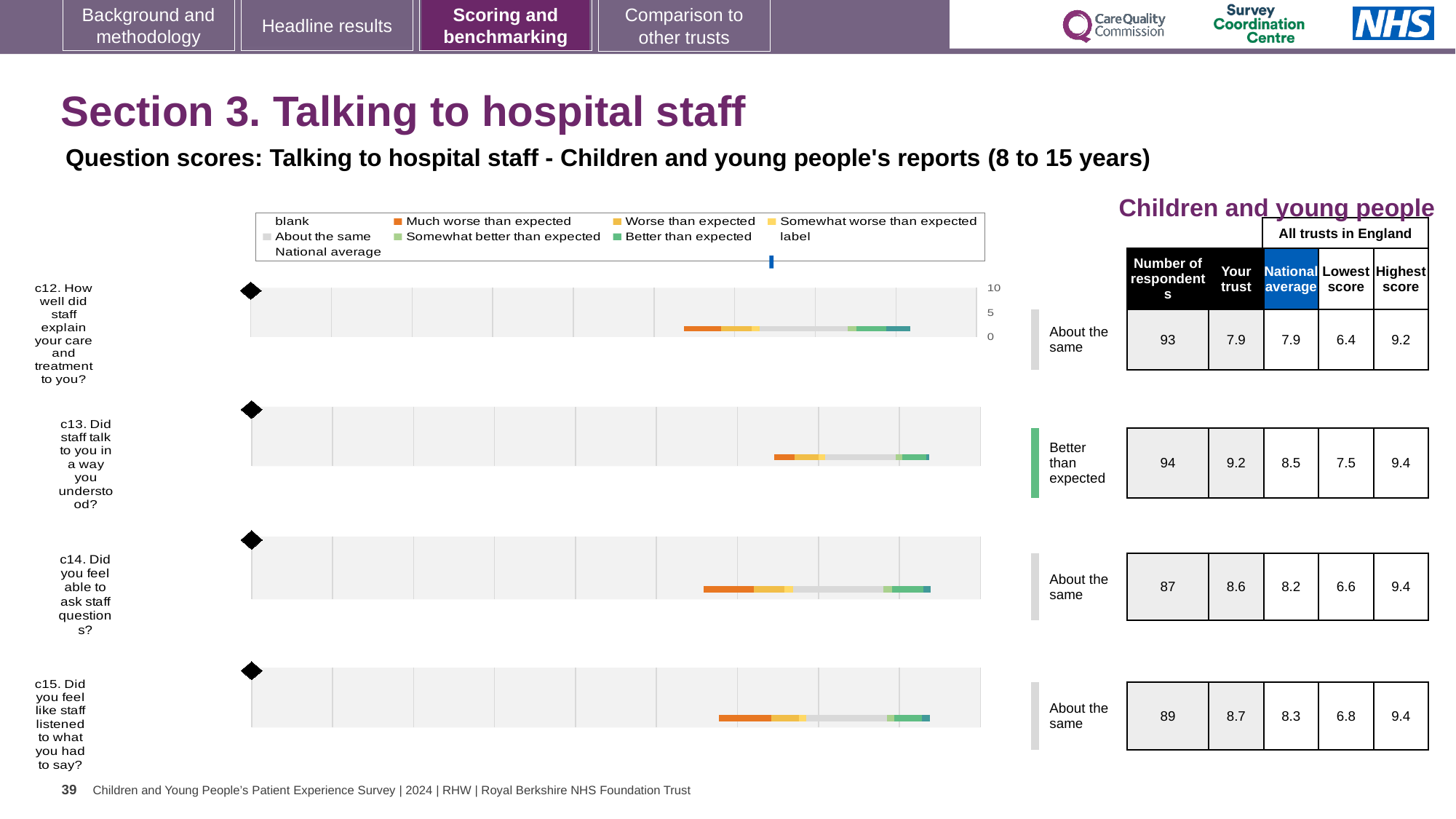
What is the highest tick value shown on the axis of the c12 chart? 10 Which question has the lowest 'Your trust' score? c12 For c14, which is larger: the 'Your trust' score or the national average? Your trust What is the difference between the 'Your trust' score and the national average for c13? 0.7 What kind of chart is used for each question on the slide? bar chart How many question charts are shown on the slide? 4 Which question has the highest 'Your trust' score? c13 How many respondents are listed for c14 (Did you feel able to ask staff questions?)? 87 What is the 'Your trust' score for c13 (Did staff talk to you in a way you understood?)? 9.2 What is the national average for c12 (How well did staff explain your care and treatment to you?)? 7.9 What is the lowest score across all trusts in England for c13? 7.5 In the legend, which colour represents 'Much worse than expected'? orange